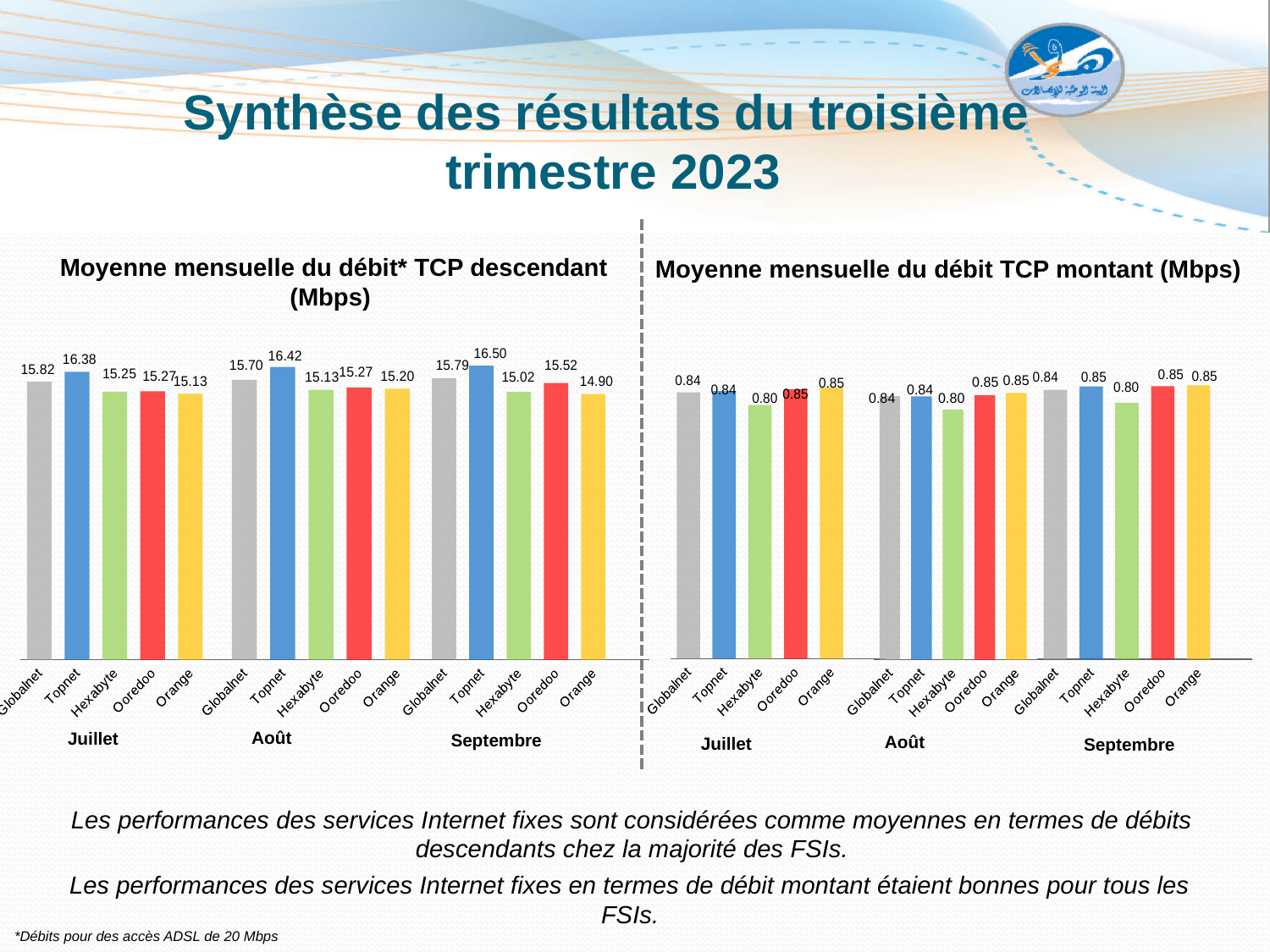
In the chart 'Moyenne mensuelle du débit* TCP descendant (Mbps)', what is the value for Topnet in Juillet? 16.38 In the chart 'Moyenne mensuelle du débit* TCP descendant (Mbps)', does the value for Topnet rise or fall from Juillet to Septembre? rise In the chart 'Moyenne mensuelle du débit* TCP descendant (Mbps)', which provider has the lowest value in Septembre? Orange In the chart 'Moyenne mensuelle du débit TCP montant (Mbps)', which provider has the lowest value in Juillet? Hexabyte In the chart 'Moyenne mensuelle du débit* TCP descendant (Mbps)', which provider has the highest value in Septembre? Topnet In the chart 'Moyenne mensuelle du débit* TCP descendant (Mbps)', which is larger in Juillet: Globalnet or Hexabyte? Globalnet In the chart 'Moyenne mensuelle du débit TCP montant (Mbps)', what is the value for Topnet in Septembre? 0.85 In the chart 'Moyenne mensuelle du débit TCP montant (Mbps)', what is the value for Hexabyte in Août? 0.80 How many bars are plotted in the chart 'Moyenne mensuelle du débit* TCP descendant (Mbps)'? 15 In the chart 'Moyenne mensuelle du débit* TCP descendant (Mbps)', what is the difference between Topnet and Globalnet in Août? 0.72 In the chart 'Moyenne mensuelle du débit* TCP descendant (Mbps)', what is the value for Orange in Septembre? 14.90 What kind of chart is 'Moyenne mensuelle du débit TCP montant (Mbps)'? bar chart